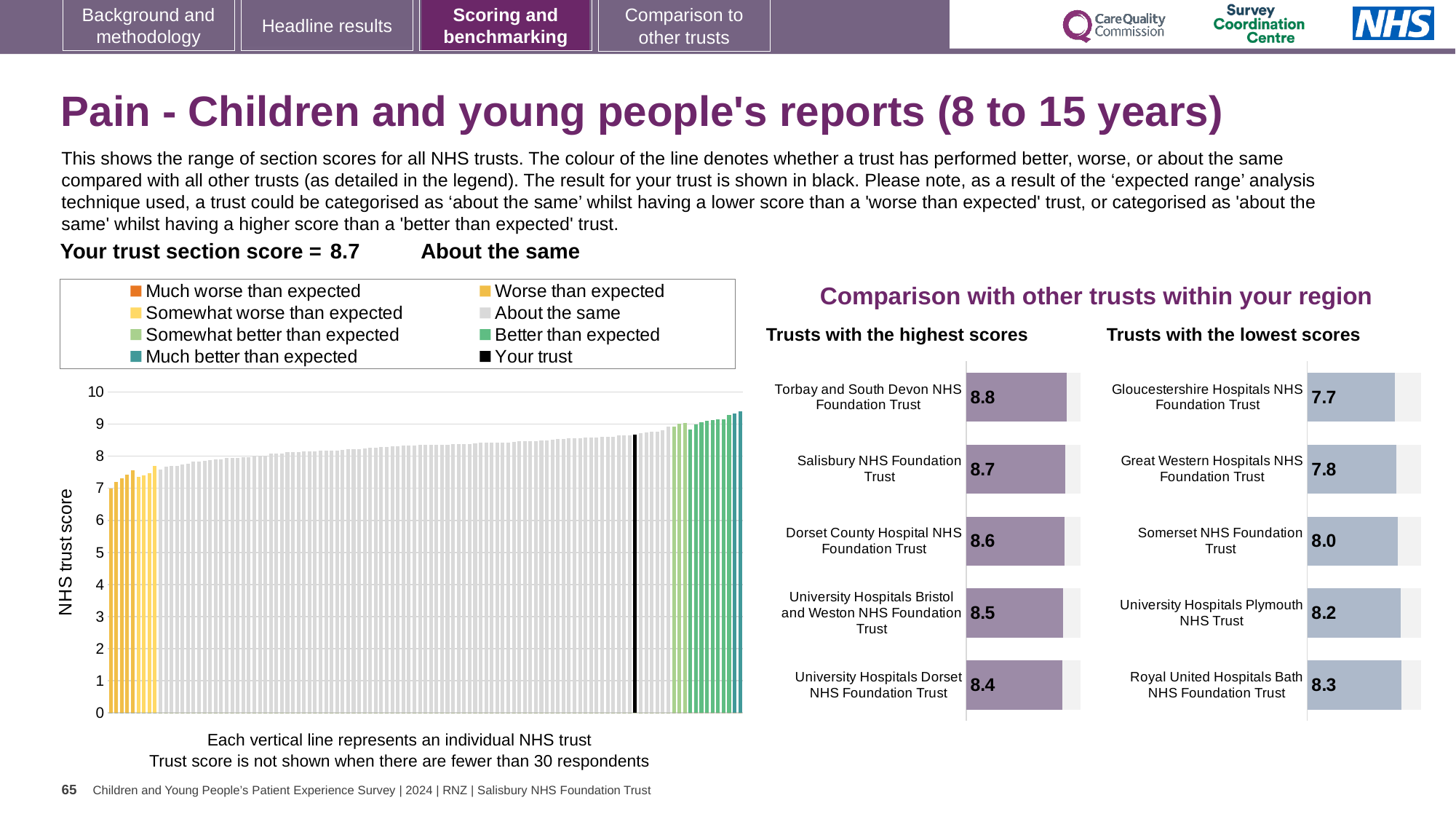
In the large 'NHS trust score' chart on the left, do the bar values rise or fall from left to right? rise How many entries does the legend above the large 'NHS trust score' chart list? 8 In the 'Trusts with the lowest scores' chart, what is the difference between the scores of Royal United Hospitals Bath NHS Foundation Trust and Gloucestershire Hospitals NHS Foundation Trust? 0.6 In the large 'NHS trust score' chart on the left, is the value of the black bar (your trust) greater or less than 8? greater In the 'Trusts with the lowest scores' chart, which trust has the lowest score? Gloucestershire Hospitals NHS Foundation Trust In the 'Trusts with the highest scores' chart, what is the score for University Hospitals Dorset NHS Foundation Trust? 8.4 In the 'Trusts with the highest scores' chart, what is the difference between the scores of Torbay and South Devon NHS Foundation Trust and University Hospitals Dorset NHS Foundation Trust? 0.4 How many trusts are shown in the 'Trusts with the highest scores' chart? 5 In the 'Trusts with the lowest scores' chart, what is the score for Somerset NHS Foundation Trust? 8.0 In the 'Trusts with the highest scores' chart, what is the score for Torbay and South Devon NHS Foundation Trust? 8.8 In the 'Trusts with the lowest scores' chart, which has the higher score: Great Western Hospitals NHS Foundation Trust or University Hospitals Plymouth NHS Trust? University Hospitals Plymouth NHS Trust In the 'Trusts with the highest scores' chart, which trust has the highest score? Torbay and South Devon NHS Foundation Trust